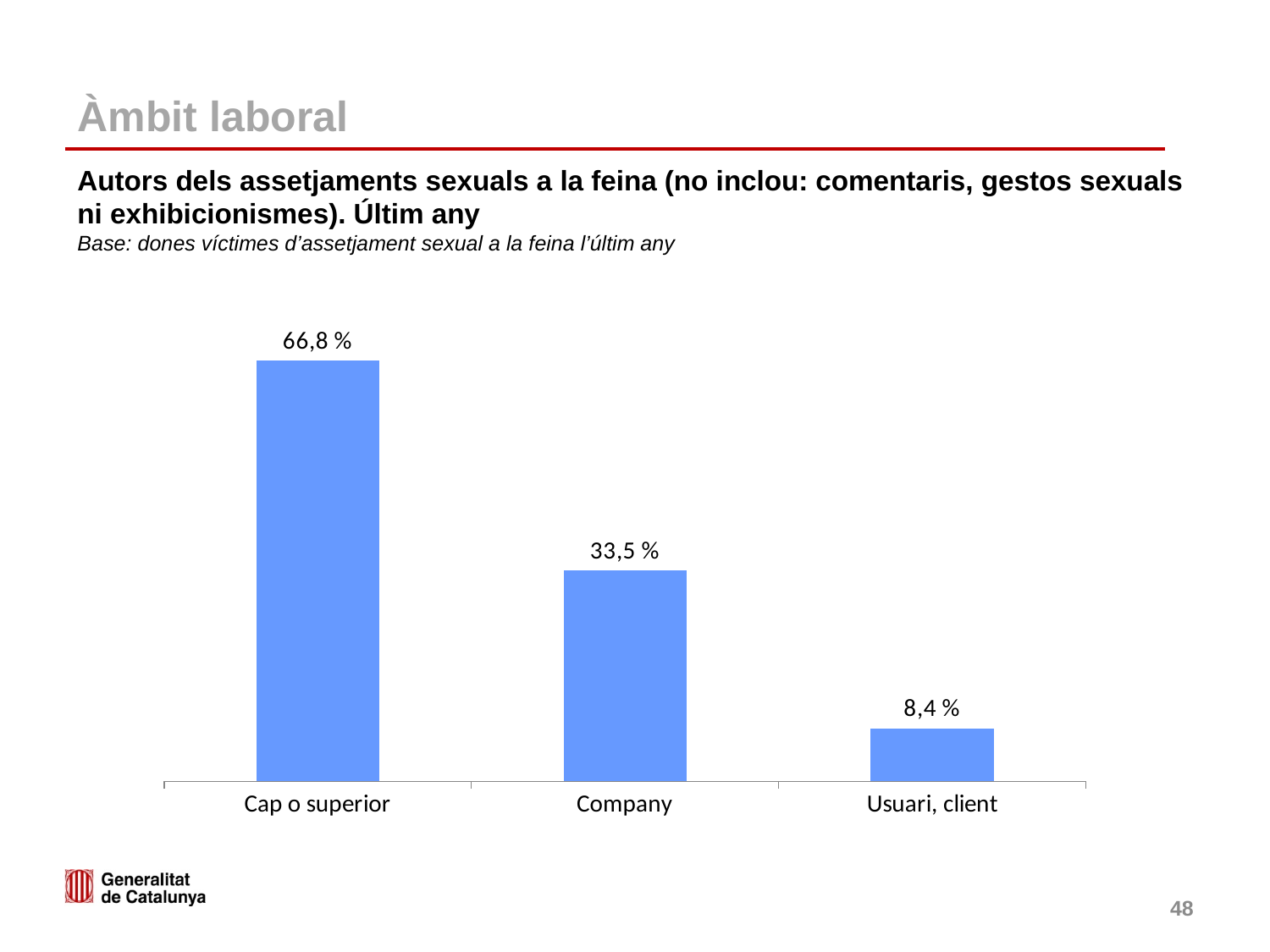
What is the difference between the values for Cap o superior and Company? 33,3 % What is the value for Cap o superior? 66,8 % What is the value for Usuari, client? 8,4 % What is the value for Company? 33,5 % What colour are the bars in the chart? Blue How many categories are shown in the chart? 3 What kind of chart is shown on the slide? Bar chart Which is larger, the value for Company or the value for Usuari, client? Company What is the difference between the values for Company and Usuari, client? 25,1 % Which category has the lowest value? Usuari, client Do the values rise or fall from left to right along the x axis? Fall Which category has the highest value? Cap o superior